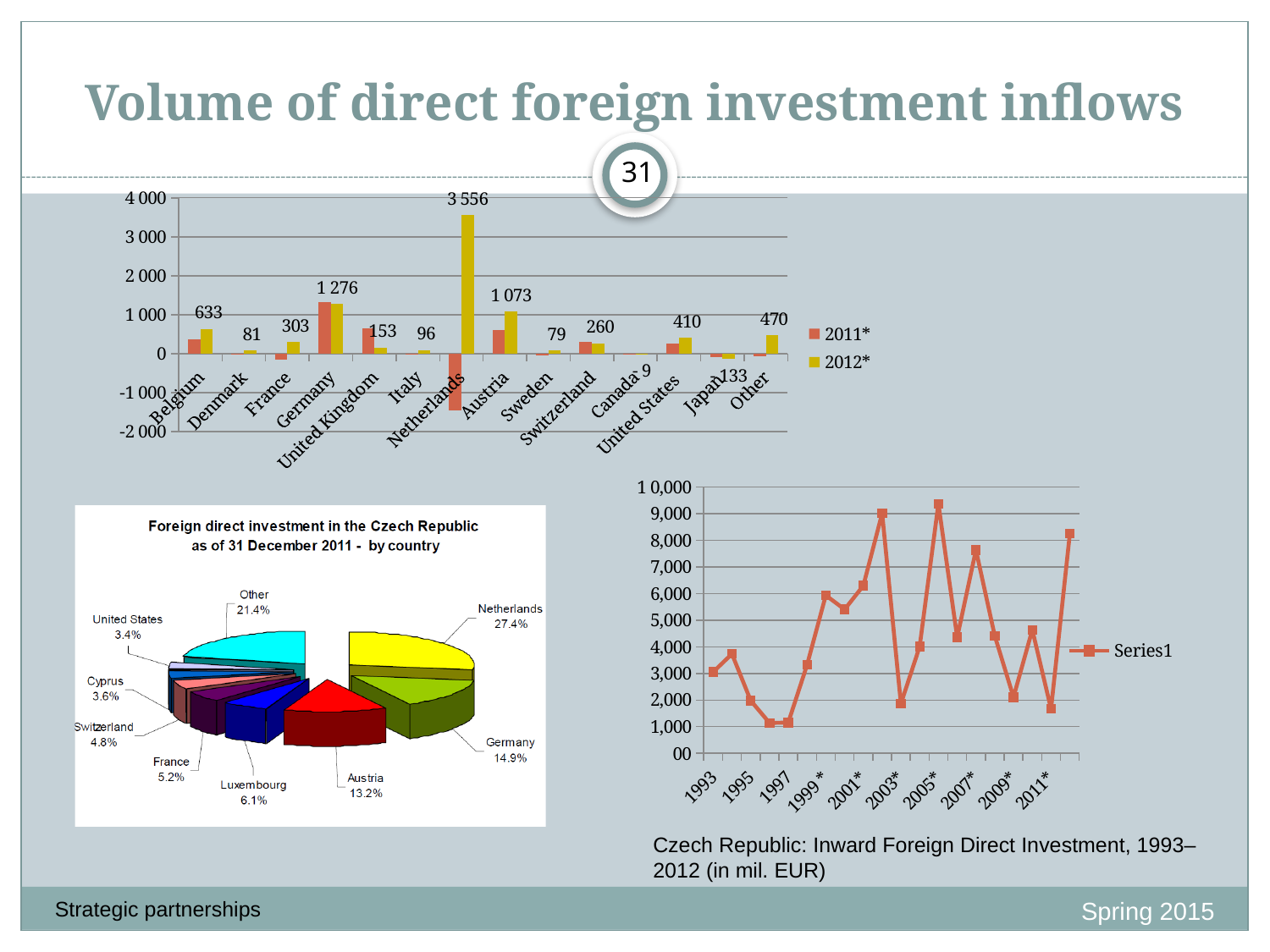
How many countries/categories are shown on the x axis of the top bar chart? 14 In the pie chart 'Foreign direct investment in the Czech Republic as of 31 December 2011 - by country', what share does Austria have? 13.2% How many series does the legend of the top bar chart list? 2 In the top bar chart, what data label is shown for Netherlands? 3 556 In the line chart 'Czech Republic: Inward Foreign Direct Investment, 1993–2012', is the value for 2003* greater or less than 8,000? less In the pie chart 'Foreign direct investment in the Czech Republic as of 31 December 2011 - by country', which named country has the smallest slice? United States In the top bar chart, what data label is shown for Germany? 1 276 In the pie chart 'Foreign direct investment in the Czech Republic as of 31 December 2011 - by country', what share does Netherlands have? 27.4% In the line chart 'Czech Republic: Inward Foreign Direct Investment, 1993–2012', is the value for 1997 greater or less than 2,000? less How many slices does the pie chart 'Foreign direct investment in the Czech Republic as of 31 December 2011 - by country' have? 9 In the top bar chart, what data label is shown for Austria? 1 073 In the top bar chart, which country has the tallest bar? Netherlands